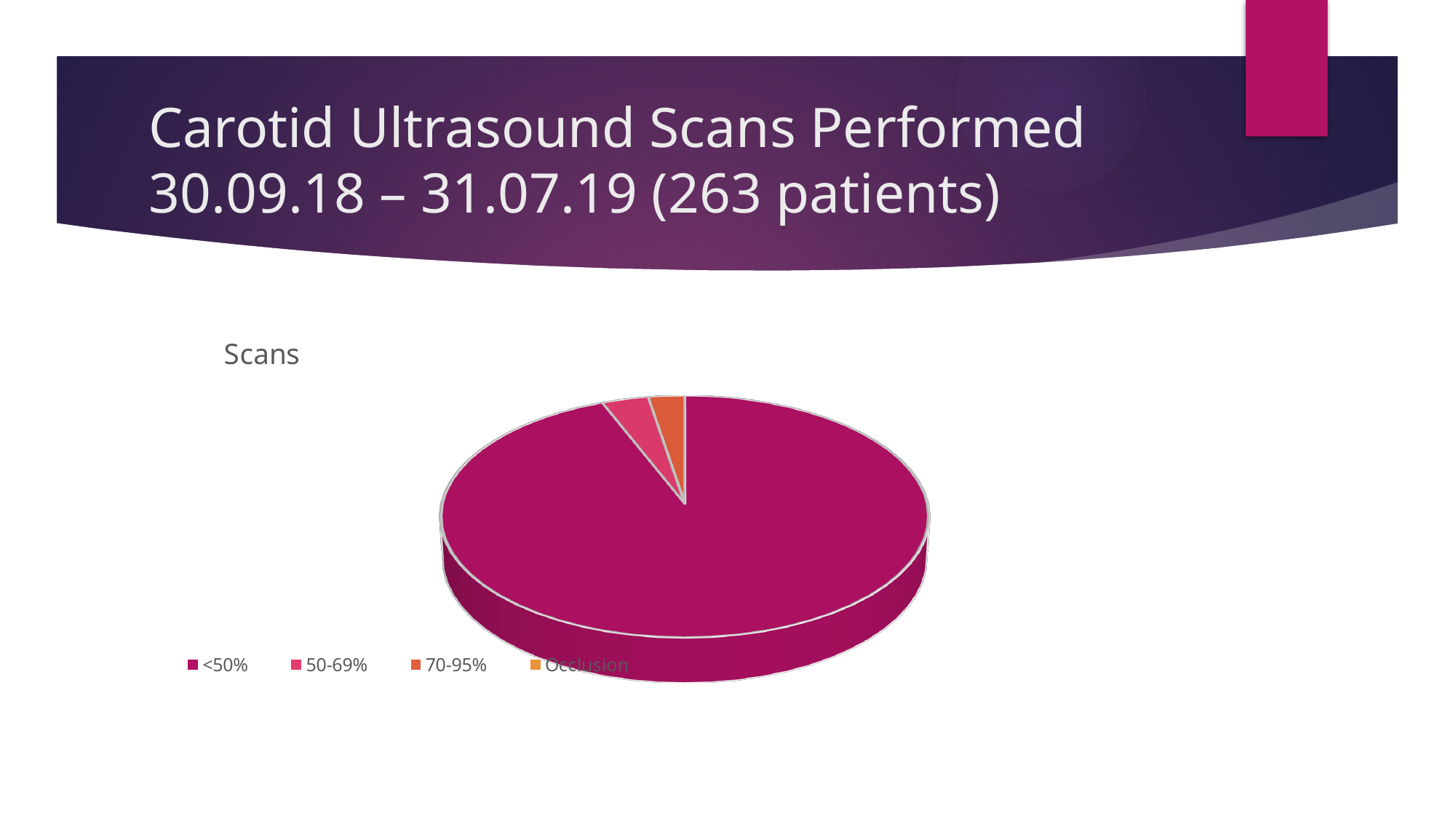
What is the title of the chart? Scans Which slice is larger, <50% or 50-69%? <50% How many categories does the chart's legend list? 4 What is the first category listed in the chart's legend? <50% Which category has the largest slice of the pie? <50% Which slice is larger, 70-95% or <50%? <50% What kind of chart is shown on the slide? pie chart